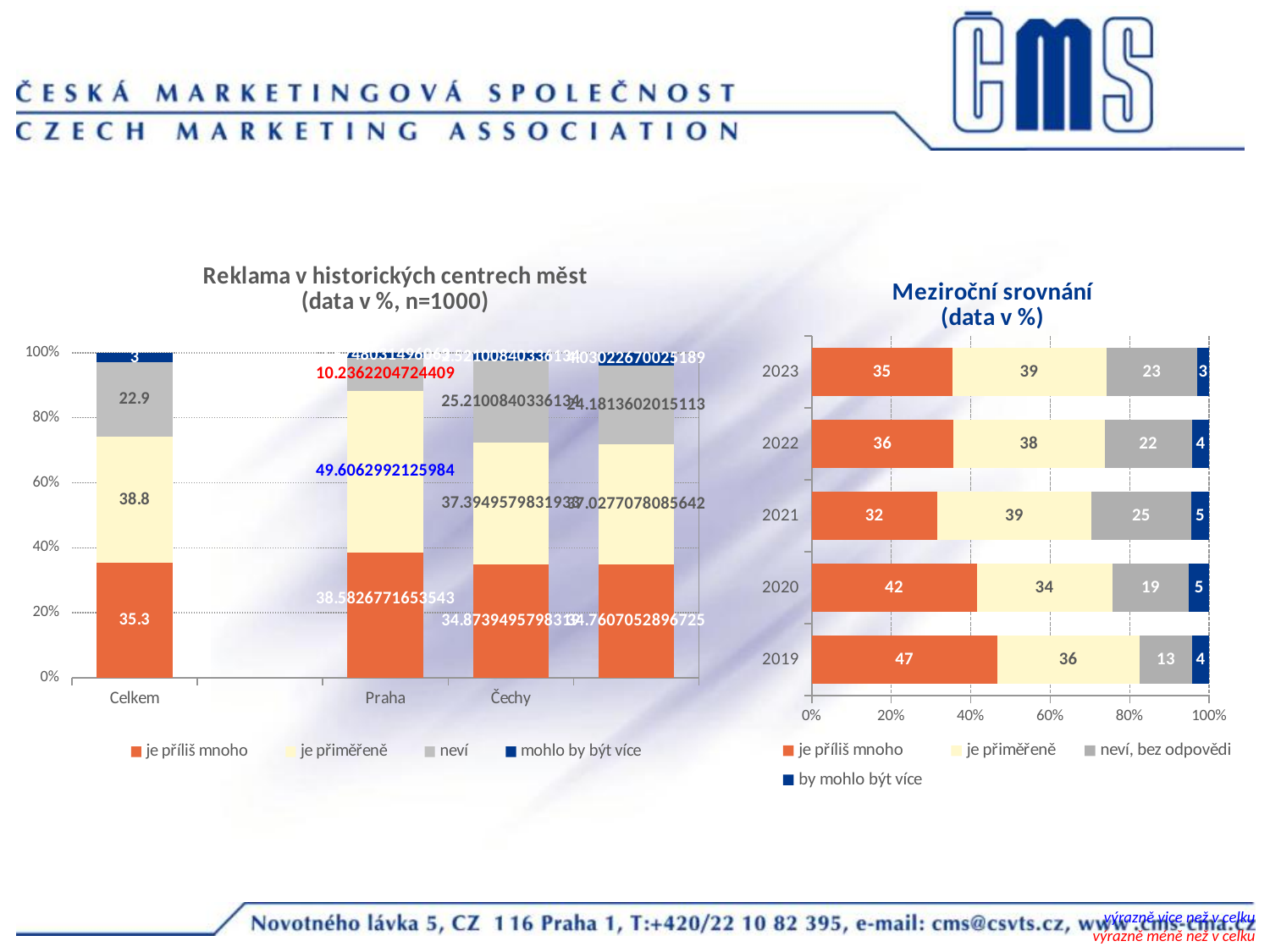
In the 'Meziroční srovnání' chart, what is the value for 'neví, bez odpovědi' in 2021? 25 In the 'Meziroční srovnání' chart, how many years are shown? 5 In the 'Reklama v historických centrech měst' chart, what is the value for 'je příliš mnoho' for Celkem? 35.3 What kind of chart is the 'Meziroční srovnání' chart? Stacked bar chart In the 'Meziroční srovnání' chart, which year has the highest value for 'je příliš mnoho'? 2019 In the 'Reklama v historických centrech měst' chart, what is the value for 'je přiměřeně' for Celkem? 38.8 In the 'Meziroční srovnání' chart, what is the difference between the 'je příliš mnoho' values for 2019 and 2023? 12 In the 'Meziroční srovnání' chart, how many series does the legend list? 4 In the 'Meziroční srovnání' chart, is the 'je přiměřeně' value larger in 2020 or in 2021? 2021 In the 'Meziroční srovnání' chart, what is the value for 'je příliš mnoho' in 2019? 47 In the 'Meziroční srovnání' chart, what is the value for 'je přiměřeně' in 2022? 38 In the 'Meziroční srovnání' chart, which year has the lowest value for 'neví, bez odpovědi'? 2019